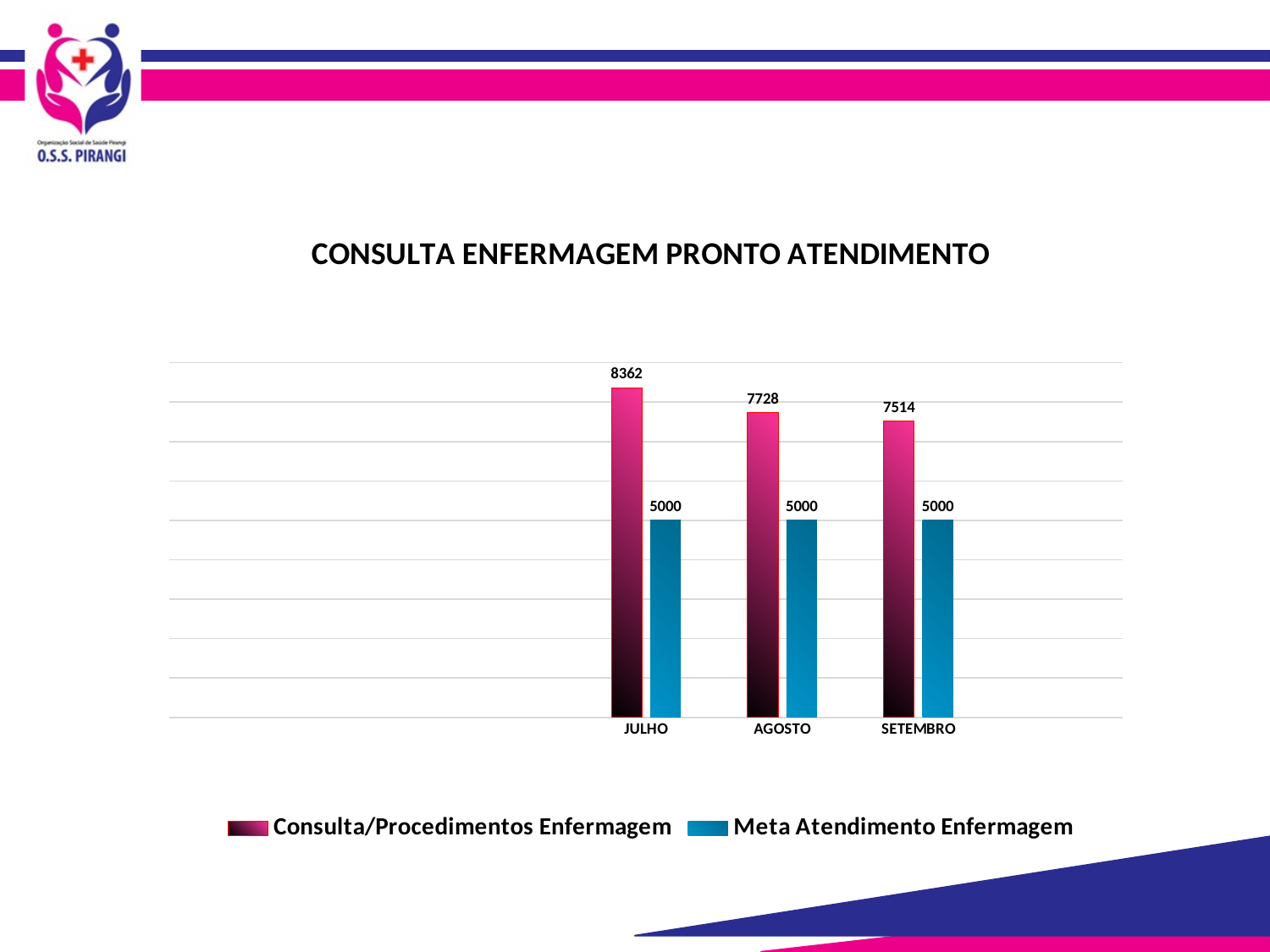
What is the Meta Atendimento Enfermagem value for AGOSTO? 5000 By how much does the Consulta/Procedimentos Enfermagem value for SETEMBRO exceed the Meta Atendimento Enfermagem value for SETEMBRO? 2514 What is the value of Consulta/Procedimentos Enfermagem for SETEMBRO? 7514 What is the difference between the Consulta/Procedimentos Enfermagem values for JULHO and AGOSTO? 634 Which is larger for AGOSTO: Consulta/Procedimentos Enfermagem or Meta Atendimento Enfermagem? Consulta/Procedimentos Enfermagem How many months are shown on the x axis? 3 What is the value of Consulta/Procedimentos Enfermagem for AGOSTO? 7728 Which month has the lowest Consulta/Procedimentos Enfermagem value? SETEMBRO How many series does the legend list? 2 What kind of chart is shown on the slide? Bar chart Which month has the highest Consulta/Procedimentos Enfermagem value? JULHO What is the value of Consulta/Procedimentos Enfermagem for JULHO? 8362